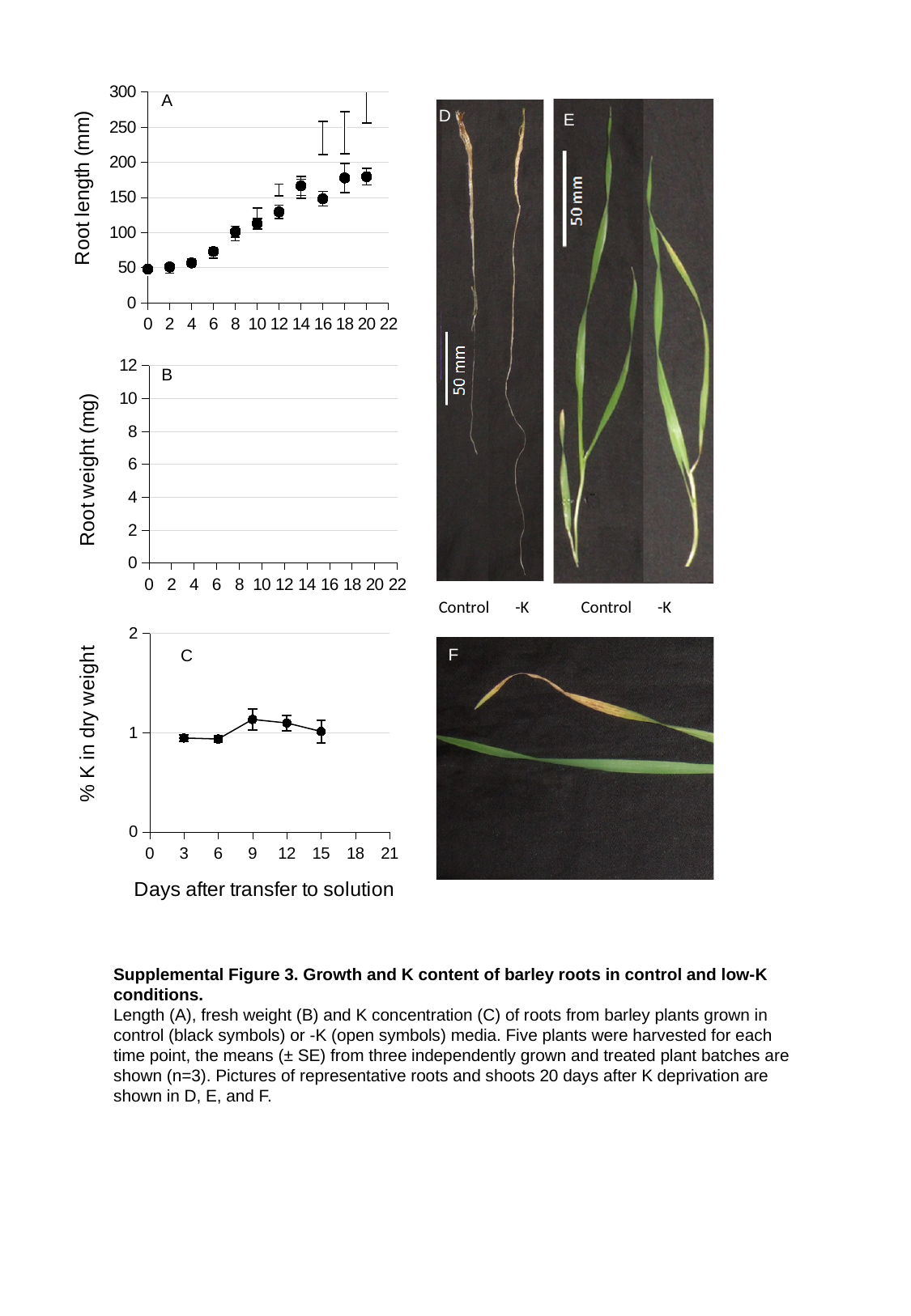
What is the x-axis label shown below chart C? Days after transfer to solution In chart A (Root length), do the values rise or fall as days after transfer increase? rise In chart C (% K in dry weight), is the value at day 9 greater or less than 1? greater In chart C (% K in dry weight), how many data points are plotted? 5 In chart C (% K in dry weight), what kind of chart is shown? line chart In chart A (Root length), is the value at day 6 greater or less than 100? less In chart A (Root length), is the value at day 12 greater or less than 100? greater Which of the three charts (A, B, C) has no data points plotted? B In chart A (Root length), which is larger, the value at day 10 or the value at day 20? day 20 In chart A (Root length), what kind of chart is shown? scatter chart